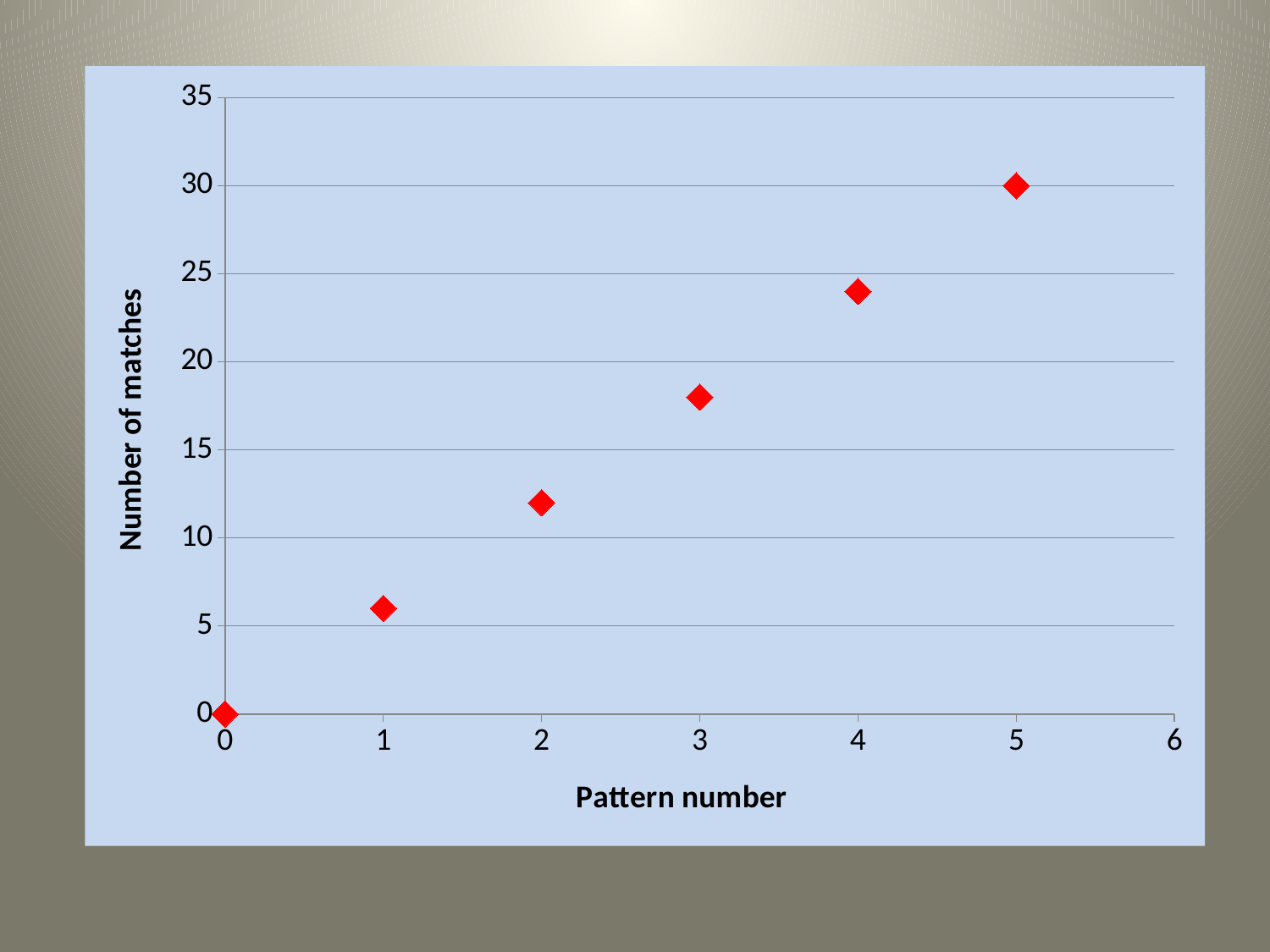
Do the number of matches rise or fall as the pattern number increases? rise What kind of chart is shown on the slide? scatter chart Is the number of matches for pattern number 1 greater or less than 5? greater Is the number of matches for pattern number 4 greater or less than 25? less Is the number of matches for pattern number 3 greater or less than 20? less What is the title of the vertical axis? Number of matches Which pattern number has the lowest number of matches? 0 How many data points are plotted on the chart? 6 What is the number of matches for pattern number 0? 0 What is the number of matches for pattern number 5? 30 Which has more matches, pattern number 2 or pattern number 4? pattern number 4 Which pattern number has the highest number of matches? 5